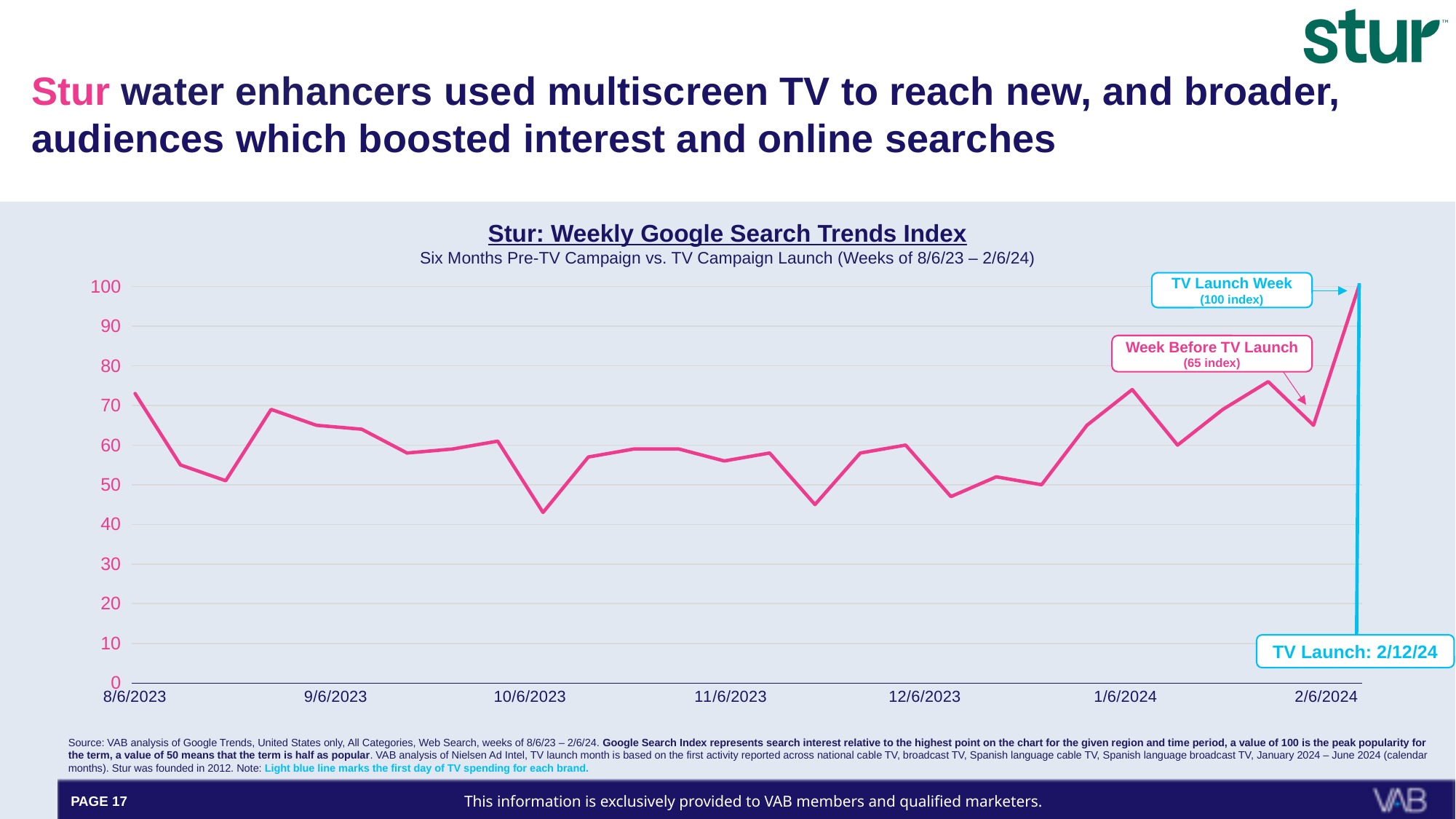
What is the difference between the TV Launch Week index and the Week Before TV Launch index? 35 Is the value for the week of 10/6/2023 greater or less than 50? less What is the index value for the TV Launch Week? 100 Is the value for the week of 1/6/2024 greater or less than 60? greater Which is larger, the index for the TV Launch Week or the Week Before TV Launch? TV Launch Week What is the title of the chart? Stur: Weekly Google Search Trends Index Does the index rise or fall from the Week Before TV Launch to the TV Launch Week? rise What is the index value for the Week Before TV Launch? 65 Which week has the highest search index value on the chart? TV Launch Week Is the value for the week of 8/6/2023 greater or less than 60? greater What date does the light blue line mark as the TV launch? 2/12/24 What kind of chart is shown on the slide? line chart